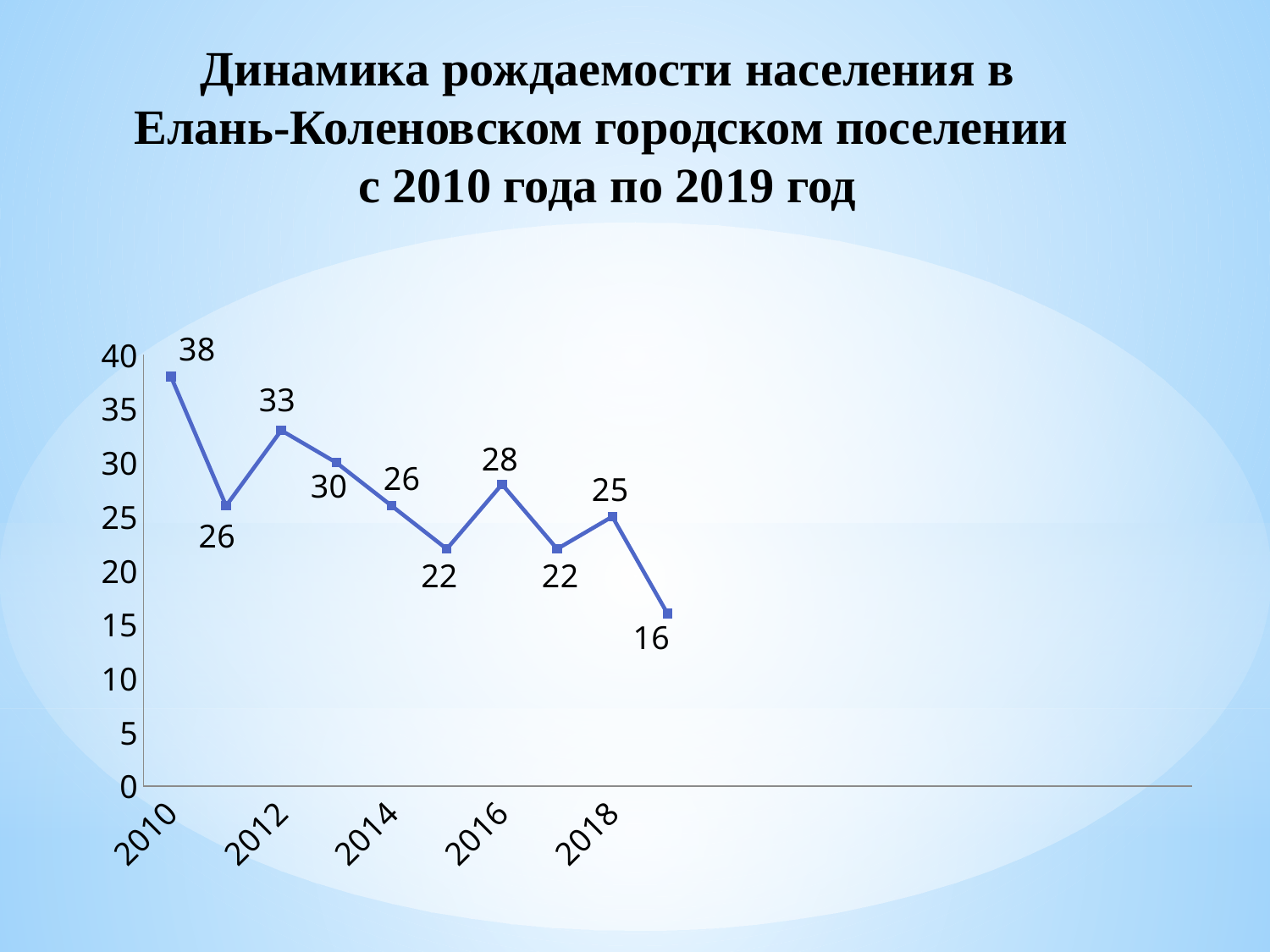
What is the value for 2014? 26 Do the values generally rise or fall from 2010 to the end of the series? fall Which year has the highest value? 2010 What is the value for 2016? 28 How many data points are plotted on the chart? 10 What is the difference between the values for 2010 and 2012? 5 What is the value for 2010? 38 Which is larger, the value for 2014 or the value for 2016? 2016 What is the lowest value plotted on the chart? 16 What is the value for 2018? 25 What kind of chart is shown on the slide? line chart What is the value for 2012? 33